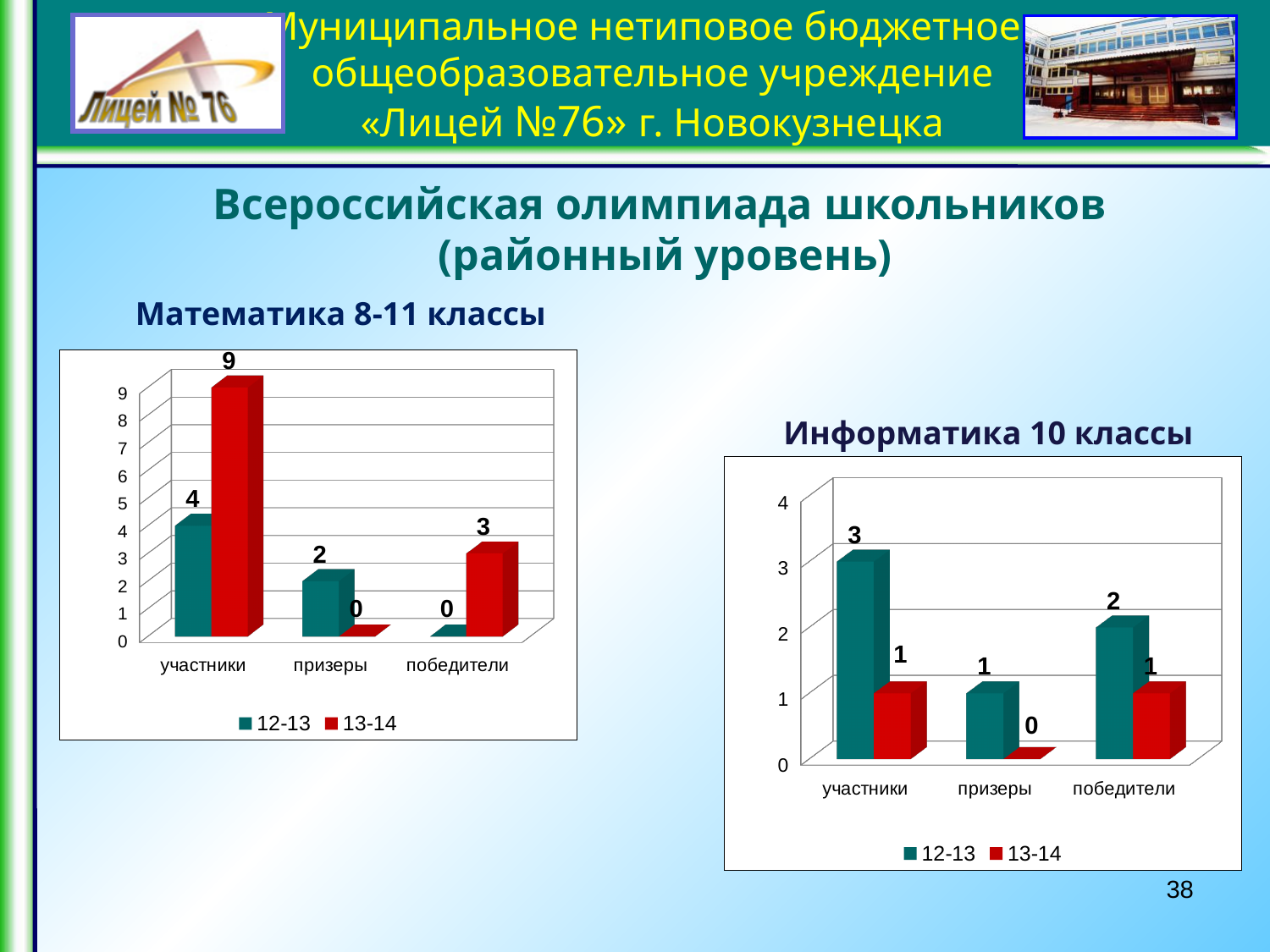
How many categories are shown on the x axis of the chart 'Математика 8-11 классы'? 3 In the chart 'Математика 8-11 классы', what is the value for победители in the 13-14 series? 3 In the chart 'Информатика 10 классы', what is the value for участники in the 12-13 series? 3 In the chart 'Информатика 10 классы', what is the value for призеры in the 13-14 series? 0 In the chart 'Информатика 10 классы', which category has the lowest value in the 12-13 series? призеры How many series does the legend of the chart 'Информатика 10 классы' list? 2 What kind of chart is 'Математика 8-11 классы'? bar chart In the chart 'Математика 8-11 классы', what is the value for участники in the 13-14 series? 9 In the chart 'Информатика 10 классы', which is larger for победители: the 12-13 value or the 13-14 value? 12-13 In the chart 'Математика 8-11 классы', what is the value for призеры in the 12-13 series? 2 In the chart 'Математика 8-11 классы', what is the difference between the 13-14 and 12-13 values for участники? 5 In the chart 'Математика 8-11 классы', which category has the highest value in the 13-14 series? участники